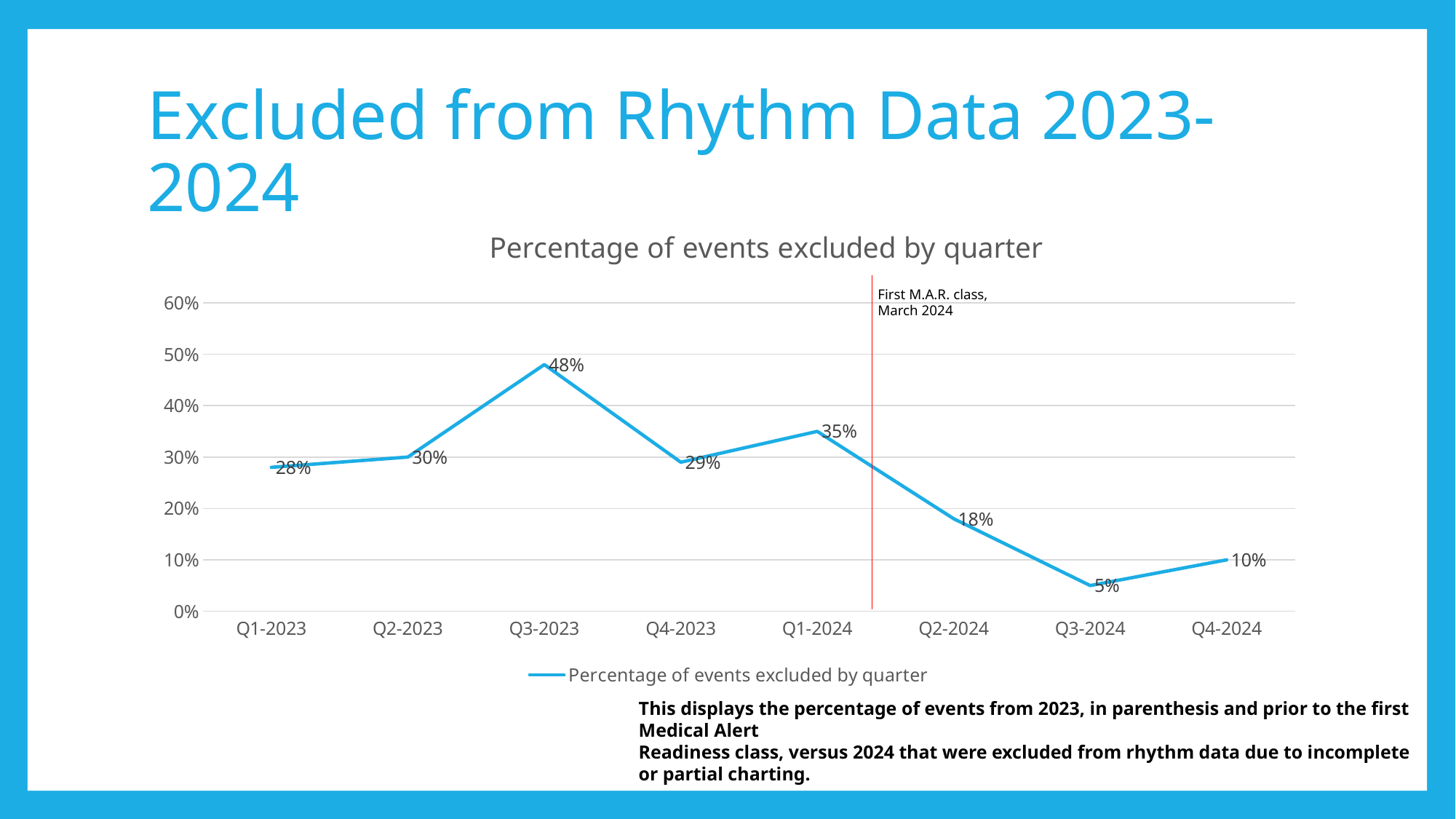
Which quarter has the highest percentage of events excluded? Q3-2023 What is the percentage of events excluded in Q1-2024? 35% What kind of chart is shown on the slide? Line chart What is the percentage of events excluded in Q3-2024? 5% Do the values rise or fall from Q1-2024 to Q3-2024? Fall Which quarter has the lowest percentage of events excluded? Q3-2024 What is the difference in percentage points between Q3-2023 and Q4-2023? 19 What event does the red vertical line on the chart mark? First M.A.R. class, March 2024 What is the percentage of events excluded in Q3-2023? 48% What is the difference in percentage points between Q1-2024 and Q2-2024? 17 How many quarters are plotted on the chart? 8 Which is larger, the value for Q2-2023 or the value for Q4-2024? Q2-2023